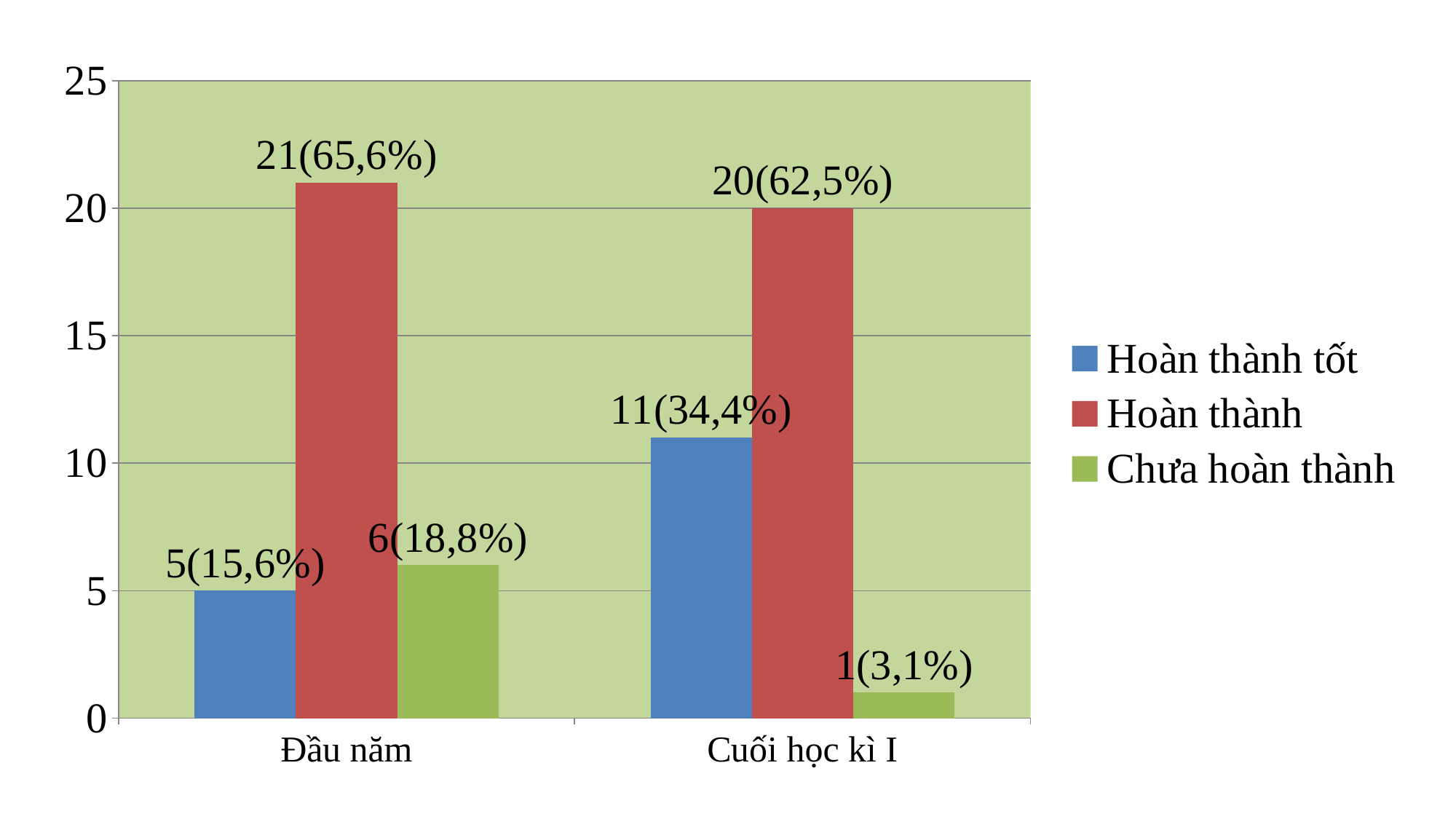
Does the value for Chưa hoàn thành rise or fall from Đầu năm to Cuối học kì I? Fall How many series does the legend list? 3 Which series has the highest value at Đầu năm? Hoàn thành Which is larger: Hoàn thành at Đầu năm or Hoàn thành at Cuối học kì I? Hoàn thành at Đầu năm What is the data label for Hoàn thành tốt at Cuối học kì I? 11(34,4%) What is the difference in count between Hoàn thành tốt at Cuối học kì I and at Đầu năm? 6 How many categories are shown on the x axis? 2 What is the data label for Hoàn thành tốt at Đầu năm? 5(15,6%) What kind of chart is this? Bar chart Which series has the lowest value at Cuối học kì I? Chưa hoàn thành What is the data label for Hoàn thành at Cuối học kì I? 20(62,5%) What is the data label for Chưa hoàn thành at Đầu năm? 6(18,8%)